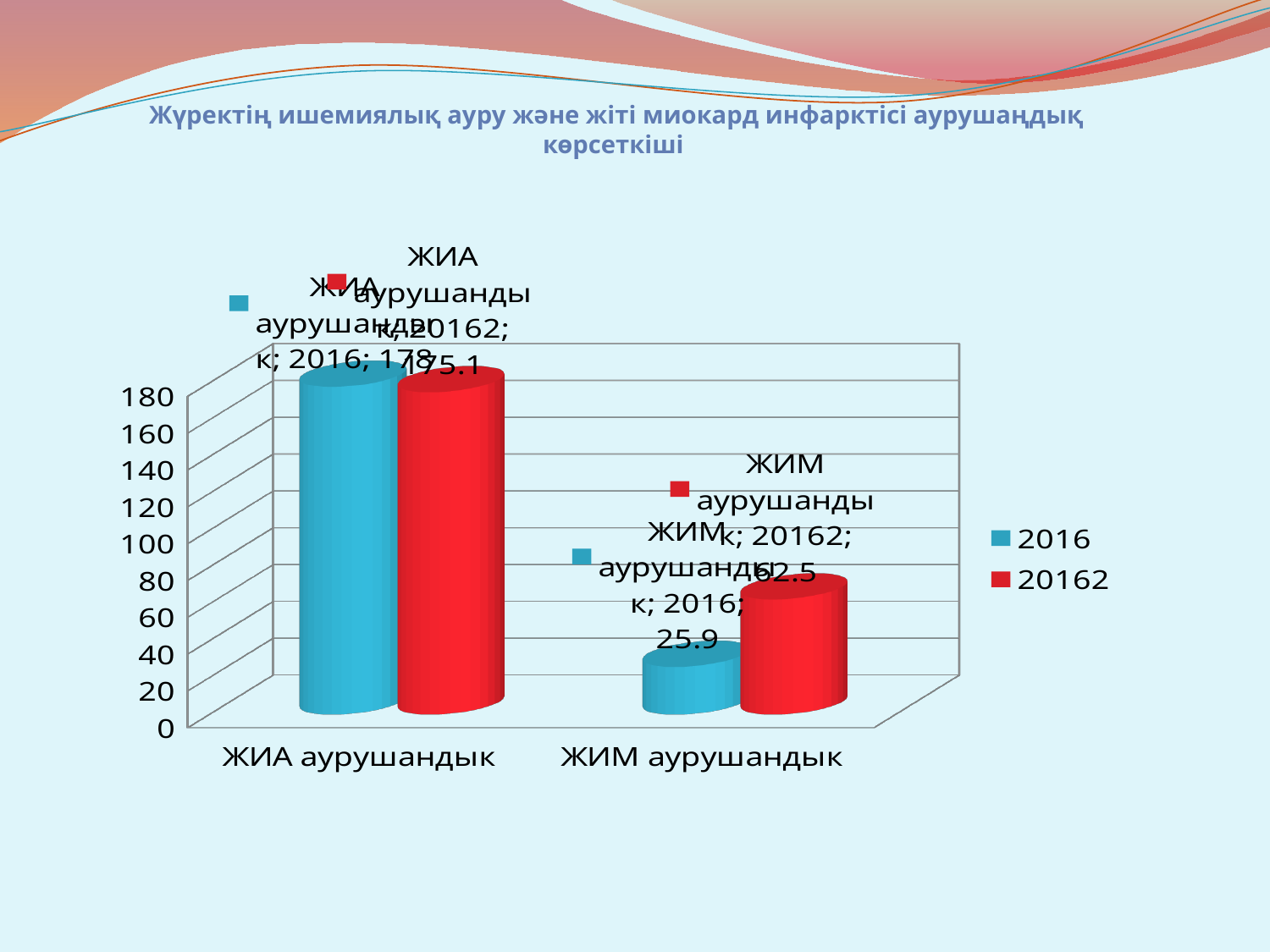
How many series does the chart legend list? 2 What is the value for ЖИМ аурушандык in the 2016 series? 25.9 What is the value for ЖИМ аурушандык in the 20162 series? 62.5 What are the two entries listed in the chart legend? 2016 and 20162 Is the value for ЖИА аурушандык in the 2016 series greater or less than 160? greater What is the value for ЖИА аурушандык in the 20162 series? 175.1 What kind of chart is shown on the slide? bar chart How many categories are shown on the x axis of the chart? 2 What is the difference between the 20162 and 2016 values for ЖИМ аурушандык? 36.6 In the 20162 series, which category has the highest value? ЖИА аурушандык For ЖИМ аурушандык, which series has the larger value, 2016 or 20162? 20162 Which bar in the chart has the lowest value? ЖИМ аурушандык, 2016